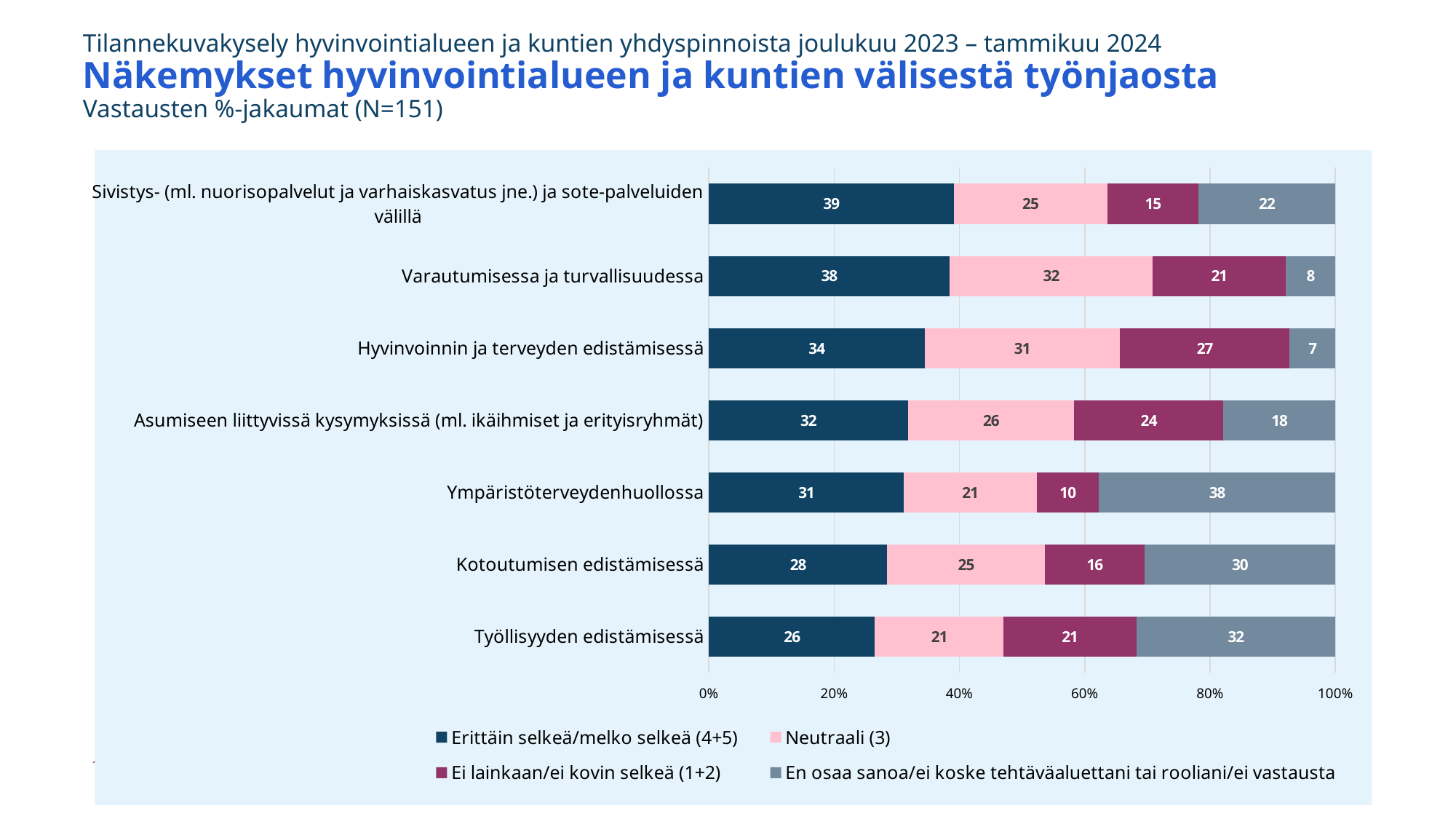
What is the value of 'Erittäin selkeä/melko selkeä (4+5)' for 'Varautumisessa ja turvallisuudessa'? 38 Which category has the lowest value for 'Erittäin selkeä/melko selkeä (4+5)'? Työllisyyden edistämisessä Which legend entry is shown in pink? Neutraali (3) What is the total of the stacked bar for 'Asumiseen liittyvissä kysymyksissä (ml. ikäihmiset ja erityisryhmät)'? 100 What kind of chart is shown on the slide? Stacked bar chart Which is larger: the 'En osaa sanoa' value for 'Kotoutumisen edistämisessä' or for 'Asumiseen liittyvissä kysymyksissä (ml. ikäihmiset ja erityisryhmät)'? Kotoutumisen edistämisessä How many series does the legend list? 4 How many categories (rows) are shown in the chart? 7 What is the value of 'Ei lainkaan/ei kovin selkeä (1+2)' for 'Hyvinvoinnin ja terveyden edistämisessä'? 27 What is the value of 'En osaa sanoa/ei koske tehtäväaluettani tai rooliani/ei vastausta' for 'Ympäristöterveydenhuollossa'? 38 What is the difference between the 'Neutraali (3)' values for 'Varautumisessa ja turvallisuudessa' and 'Työllisyyden edistämisessä'? 11 Which category has the highest value for 'Erittäin selkeä/melko selkeä (4+5)'? Sivistys- (ml. nuorisopalvelut ja varhaiskasvatus jne.) ja sote-palveluiden välillä